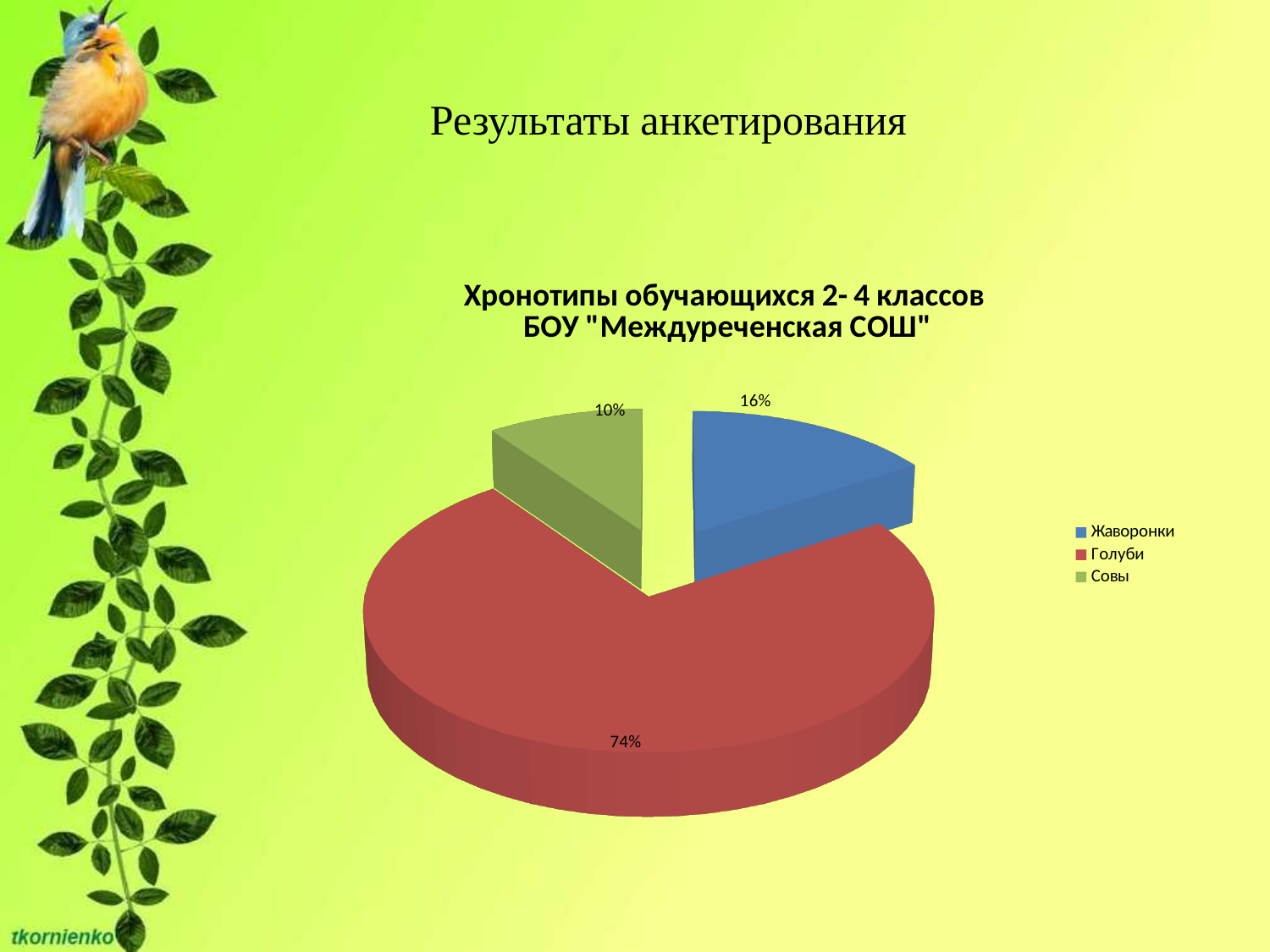
How many categories does the pie chart have? 3 Which is larger, the share for Жаворонки or the share for Совы? Жаворонки Which category has the smallest slice of the pie? Совы What is the difference between the shares of Голуби and Жаворонки? 58% What share of the pie does Жаворонки have? 16% What share of the pie does Голуби have? 74% What kind of chart is shown on the slide? pie chart What is the difference between the shares of Жаворонки and Совы? 6% What is the title of the chart? Хронотипы обучающихся 2- 4 классов БОУ "Междуреченская СОШ" Which colour represents Голуби in the chart? red What share of the pie does Совы have? 10% Which category has the largest slice of the pie? Голуби